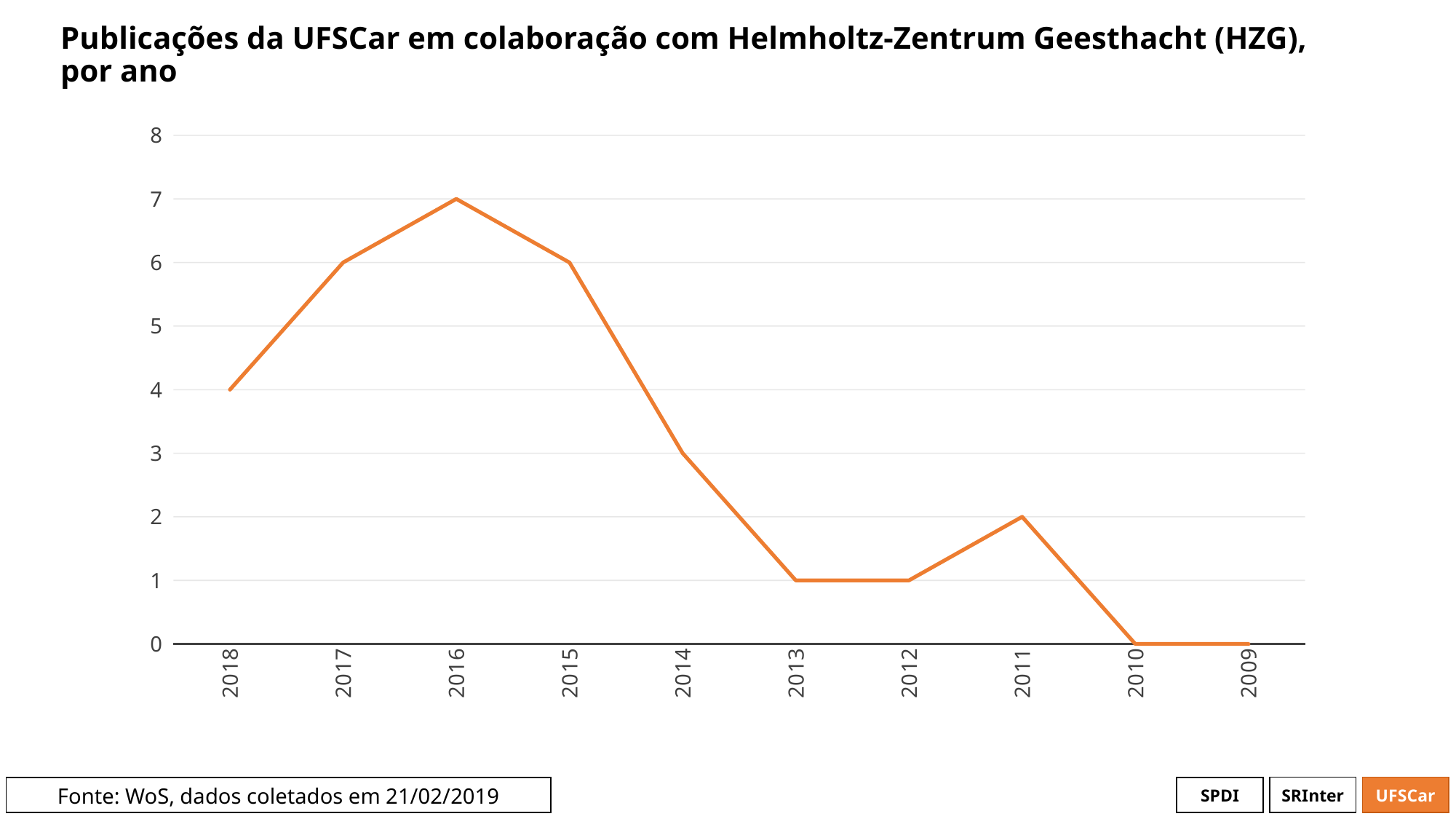
What is the value for 2011? 2 Is the value for 2015 greater or less than 5? greater What is the source cited at the bottom of the slide? WoS, dados coletados em 21/02/2019 Which year has the highest value? 2016 What kind of chart is shown on the slide? line chart What is the value for 2018? 4 How many years are plotted on the x axis? 10 What is the value for 2016? 7 What is the value for 2014? 3 Do the values generally rise or fall moving from left (2018) to right (2009) along the x axis? fall Which is larger, the value for 2017 or the value for 2018? 2017 What is the difference between the values for 2016 and 2014? 4